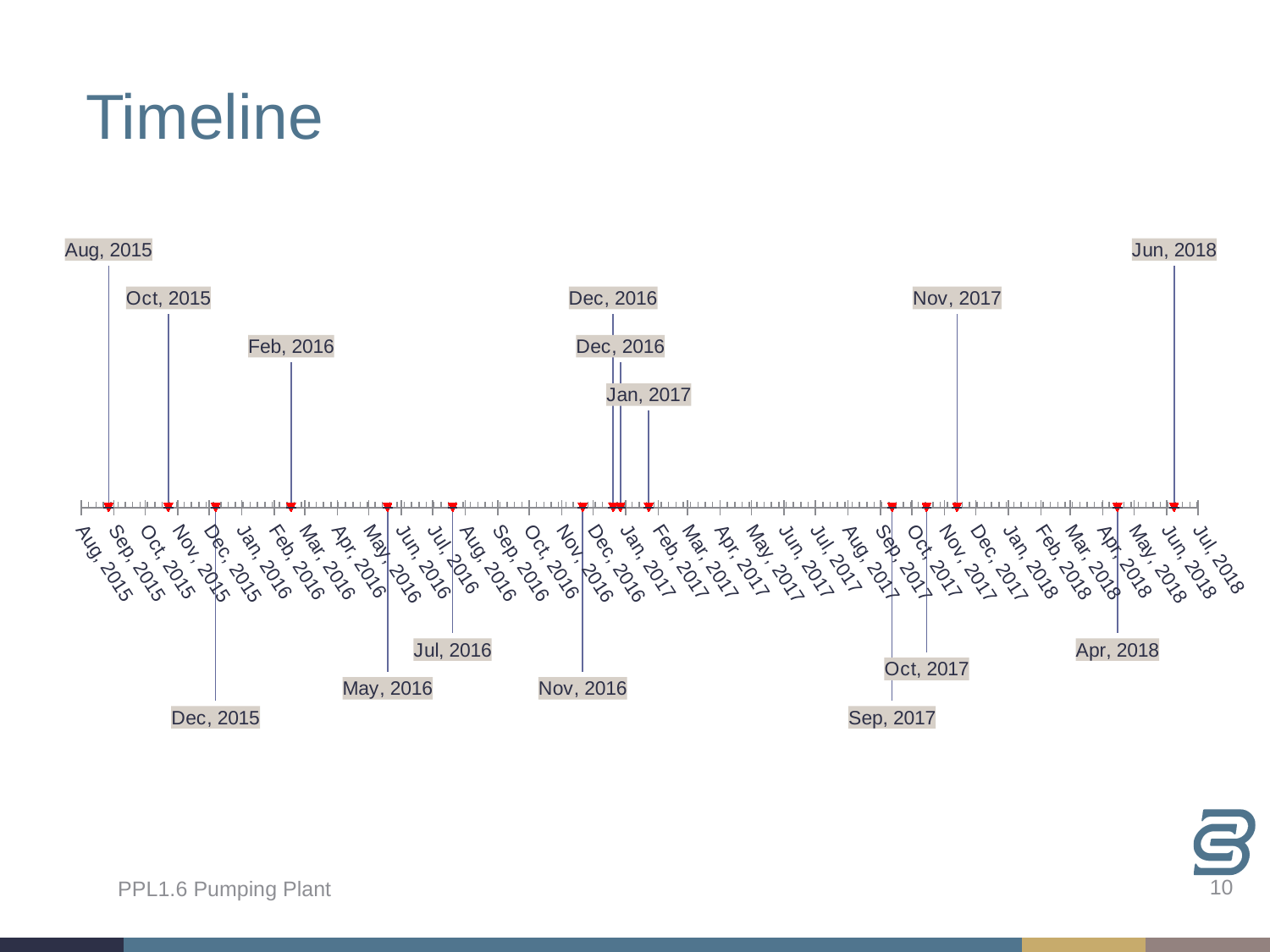
What kind of chart is shown on the slide? Timeline chart What is the last month label on the timeline axis? Jul, 2018 How many milestones are labelled with dates in 2015? 3 What is the earliest milestone date labelled on the timeline? Aug, 2015 What is the first month label on the timeline axis? Aug, 2015 How many milestones are labelled Dec, 2016? 2 How many milestones are labelled with dates in 2018? 2 What is the title of the chart on the slide? Timeline What is the latest milestone date labelled on the timeline? Jun, 2018 What colour are the milestone markers on the timeline axis? Red Which milestone comes earlier on the timeline, Feb, 2016 or May, 2016? Feb, 2016